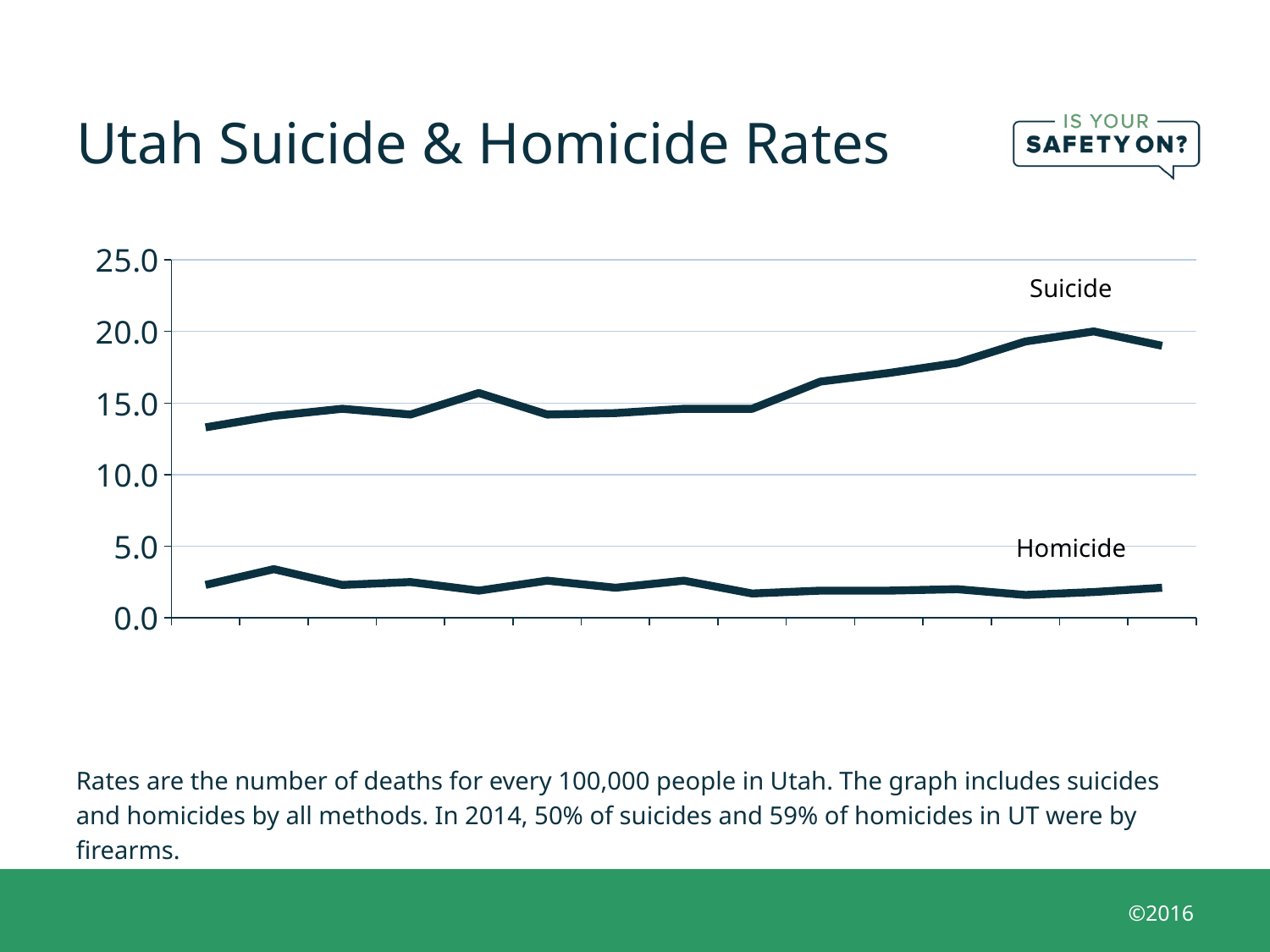
Does the Suicide line generally rise or fall from left to right across the chart? Rise Is the highest value on the Homicide line greater or less than 5.0? less Is the lowest value on the Suicide line greater or less than 10.0? greater How many series are plotted on the chart? 2 Which series has the higher values throughout the chart, Suicide or Homicide? Suicide Is the highest value on the Suicide line greater or less than 15.0? greater What is the highest value shown on the vertical axis of the chart? 25.0 What kind of chart is shown on the slide? Line chart Which two series are labeled on the chart? Suicide and Homicide What is the title of the chart on the slide? Utah Suicide & Homicide Rates